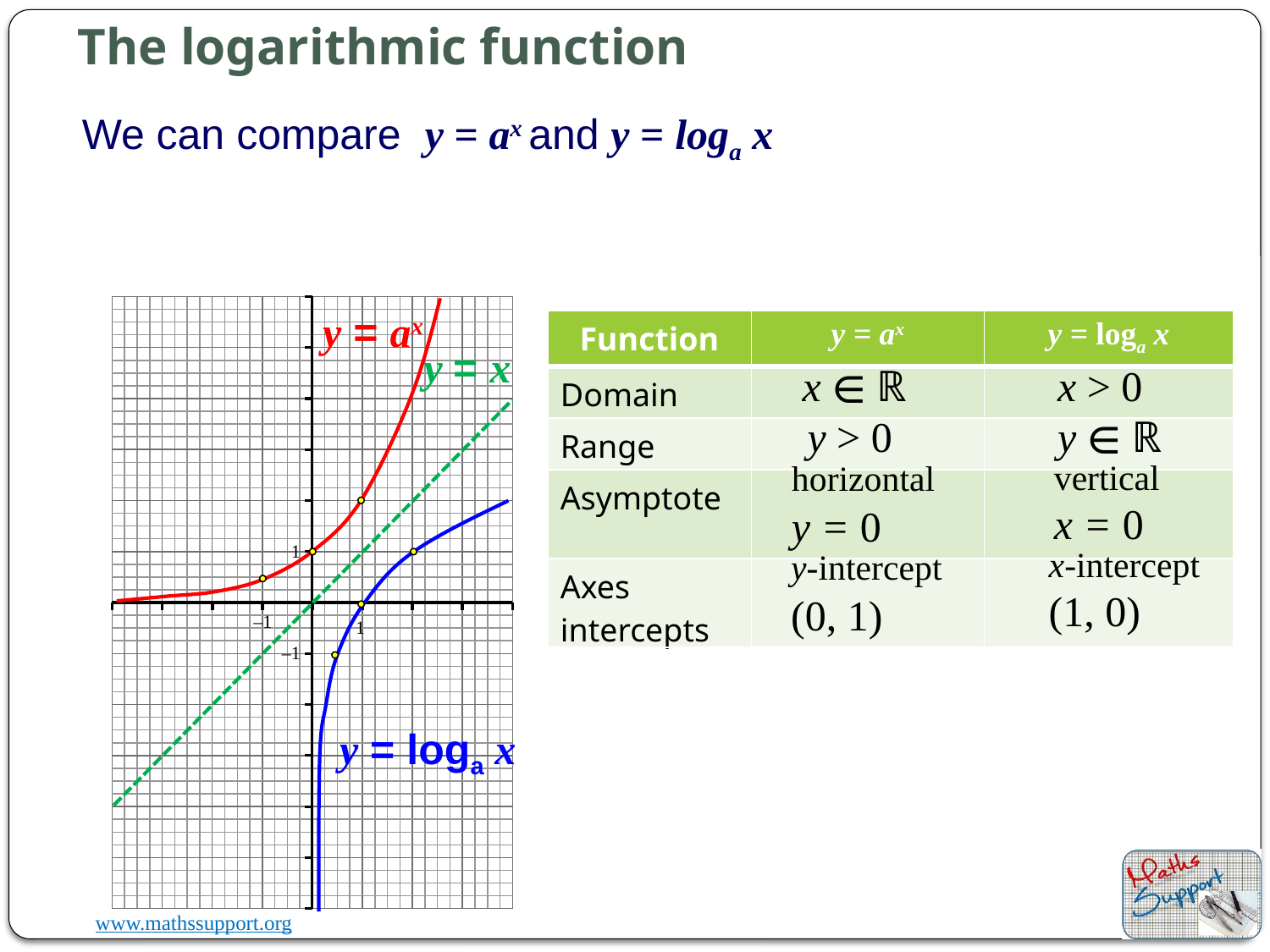
What is the y-intercept of the red curve y = a^x on the graph? 1 How many curves are plotted on the graph? 3 Does the red curve y = a^x rise or fall as x increases? rise Is the value of y = a^x at x = 1 greater or less than 1? greater Is the value of y = a^x at x = -1 greater or less than 1? less At x = 1, which curve has the larger y value, y = a^x or y = log_a x? y = a^x Which curve on the graph is drawn as a dashed line? y = x Does the blue curve y = log_a x rise or fall as x increases? rise At what x value does the blue curve y = log_a x cross the x-axis? 1 What colour is the curve y = log_a x on the graph? blue What kind of chart is shown on the left of the slide? line chart